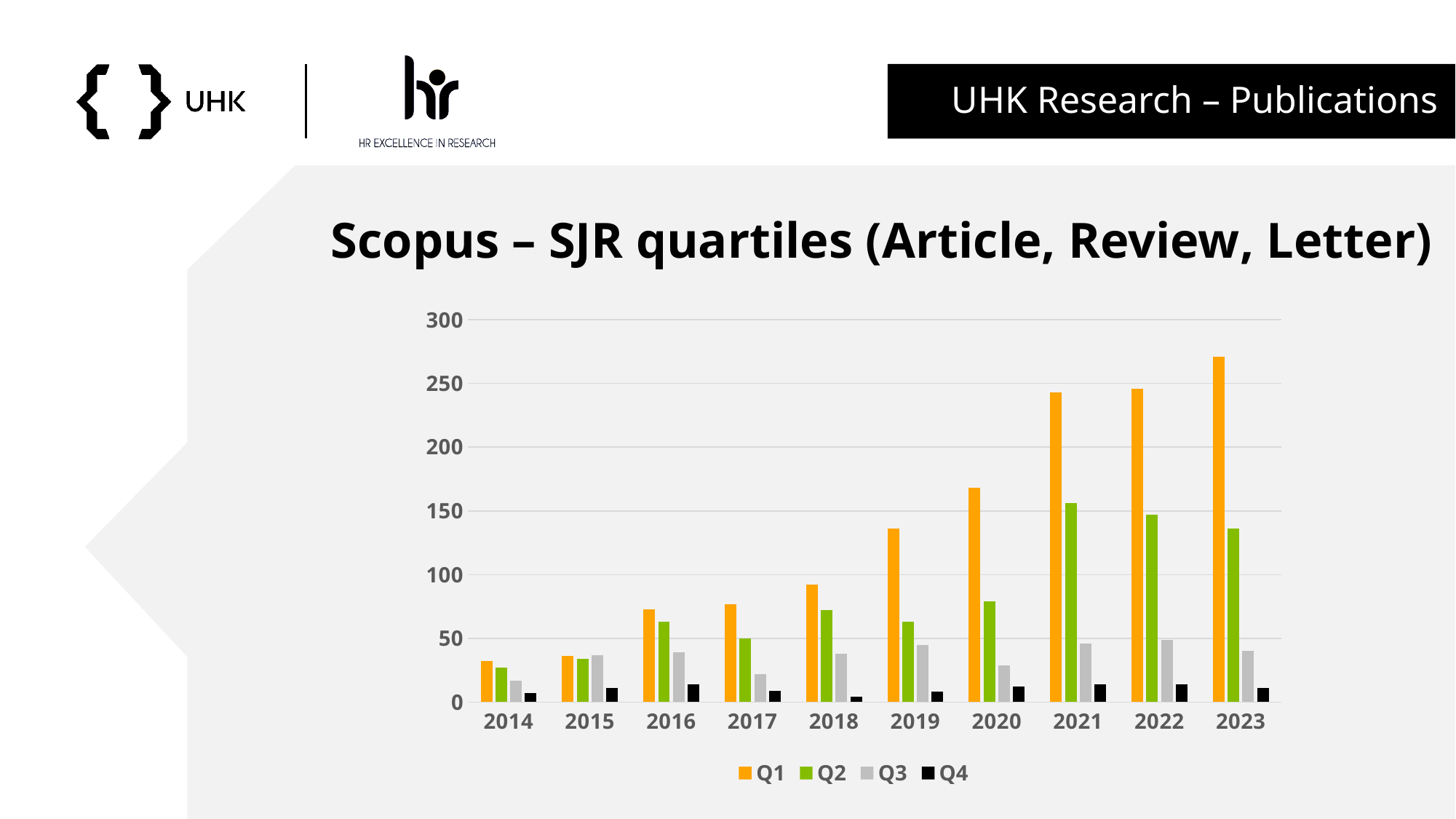
Is the Q1 value for 2020 greater or less than 150? greater How many years are shown on the x axis? 10 What colour represents the Q1 series in the legend? Orange Which is larger, the Q2 value for 2021 or the Q2 value for 2023? 2021 In 2023, which is larger, the Q1 value or the Q2 value? Q1 What kind of chart is shown on the slide? Bar chart Is the Q1 value for 2014 greater or less than 50? less Is the Q2 value for 2021 greater or less than 100? greater In which year is the Q1 value highest? 2023 Do the Q1 values generally rise or fall from 2014 to 2023? rise How many series does the legend list? 4